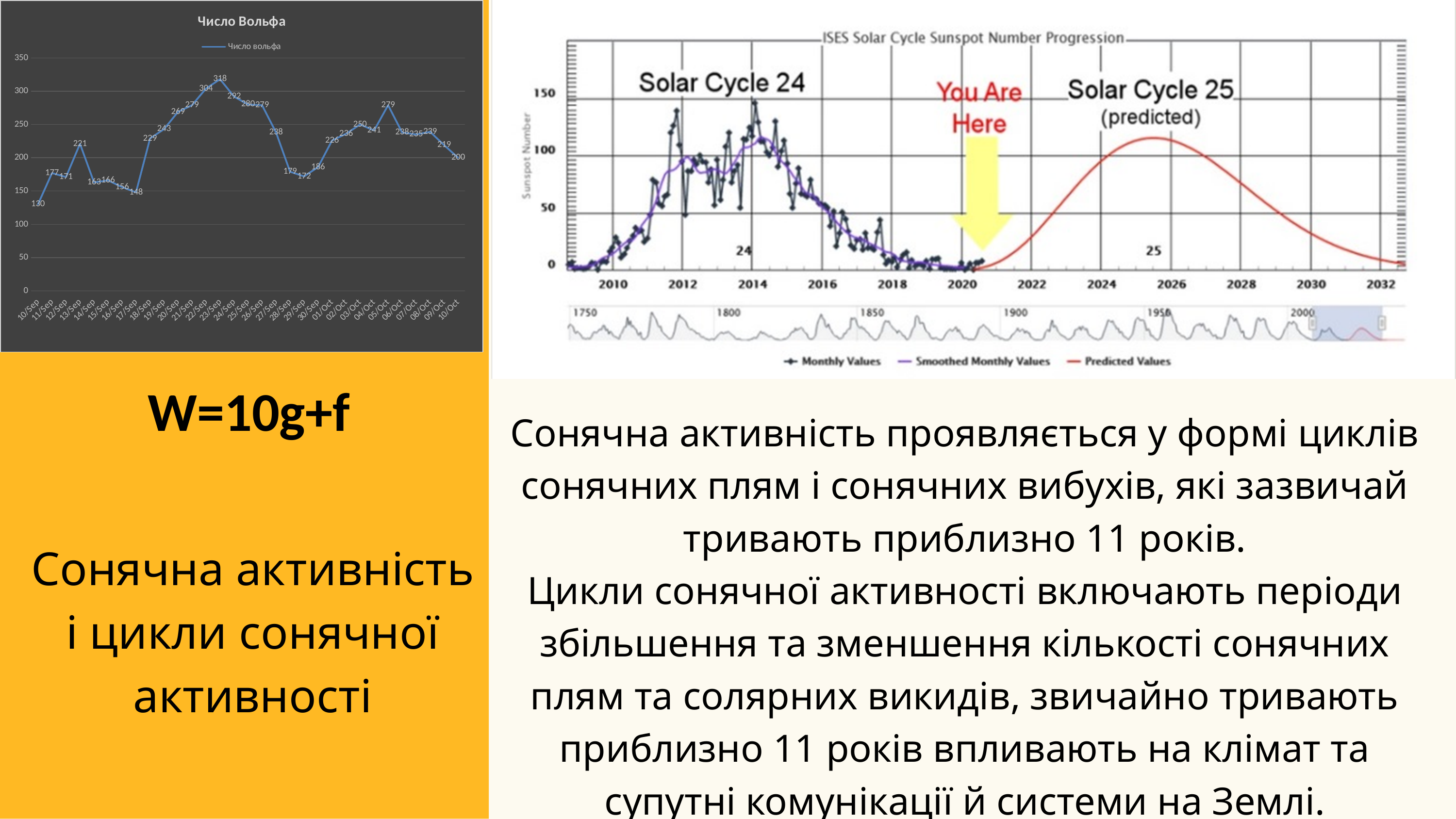
On the left chart titled "Число Вольфа", which date has the highest value? 23/Sep On the right chart, how many series does the legend list? 3 On the left chart titled "Число Вольфа", which date has the lowest value? 10/Sep On the left chart titled "Число Вольфа", which is larger: the value for 13/Sep or the value for 17/Sep? 13/Sep On the right chart, is the predicted peak of Solar Cycle 25 greater or less than 150? less On the left chart titled "Число Вольфа", what is the value for 10/Oct? 200 On the left chart titled "Число Вольфа", how many series does the legend list? 1 On the left chart titled "Число Вольфа", how many data points are plotted? 31 On the left chart titled "Число Вольфа", what is the difference between the values for 23/Sep and 10/Sep? 188 What kind of chart is the left chart titled "Число Вольфа"? line chart What is the title of the right chart? ISES Solar Cycle Sunspot Number Progression On the left chart titled "Число Вольфа", what is the value for 23/Sep? 318